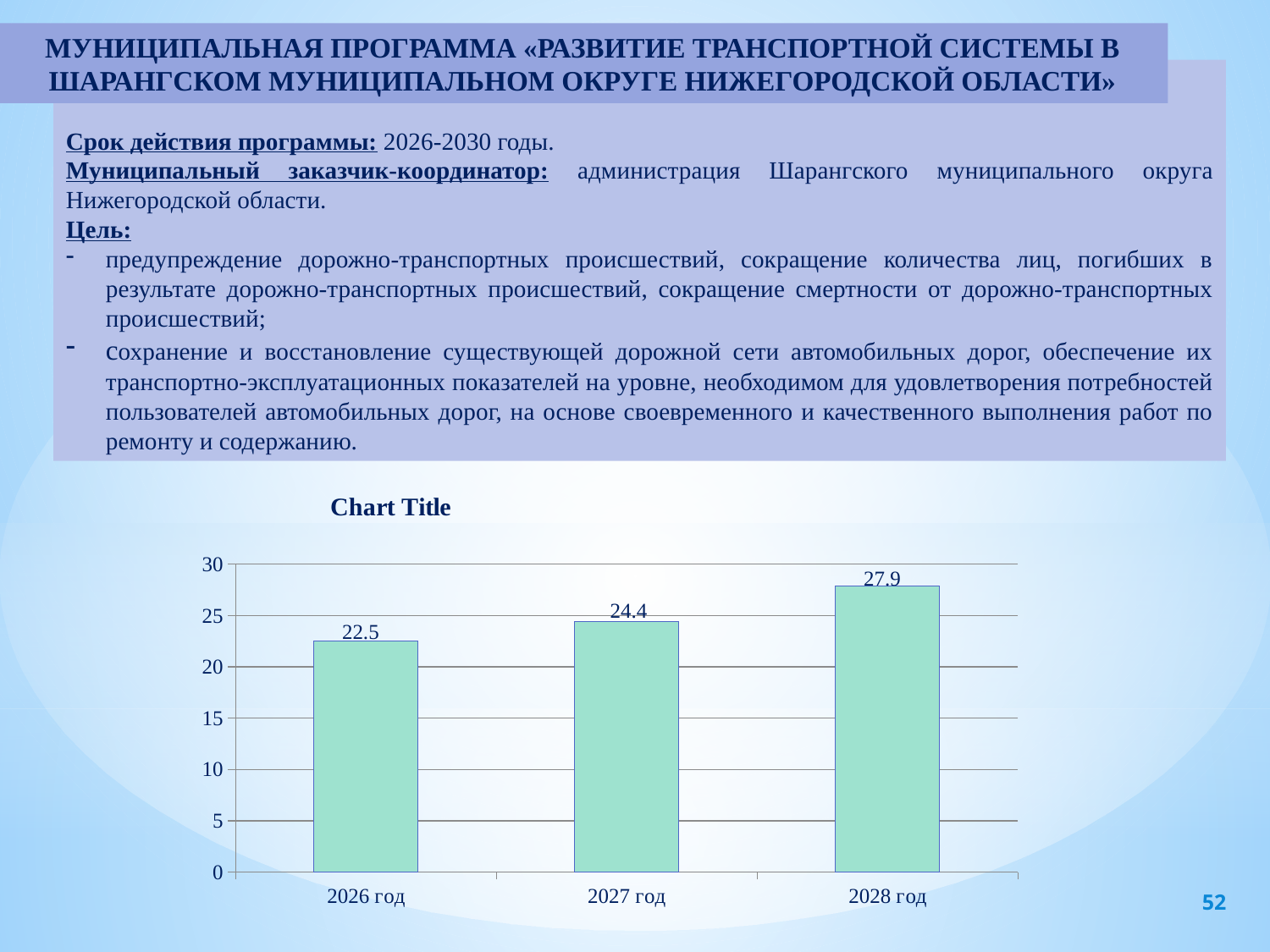
How many categories are shown on the x axis? 3 What is the value for 2027 год? 24.4 Is the value for 2028 год greater or less than 25? greater What kind of chart is shown on the slide? bar chart Which year has the lowest value? 2026 год What is the difference between the values for 2028 год and 2026 год? 5.4 What is the value for 2028 год? 27.9 Do the values rise or fall from 2026 год to 2028 год? rise Which is larger, the value for 2027 год or the value for 2028 год? 2028 год Which year has the highest value? 2028 год What is the difference between the values for 2027 год and 2026 год? 1.9 What is the value for 2026 год? 22.5